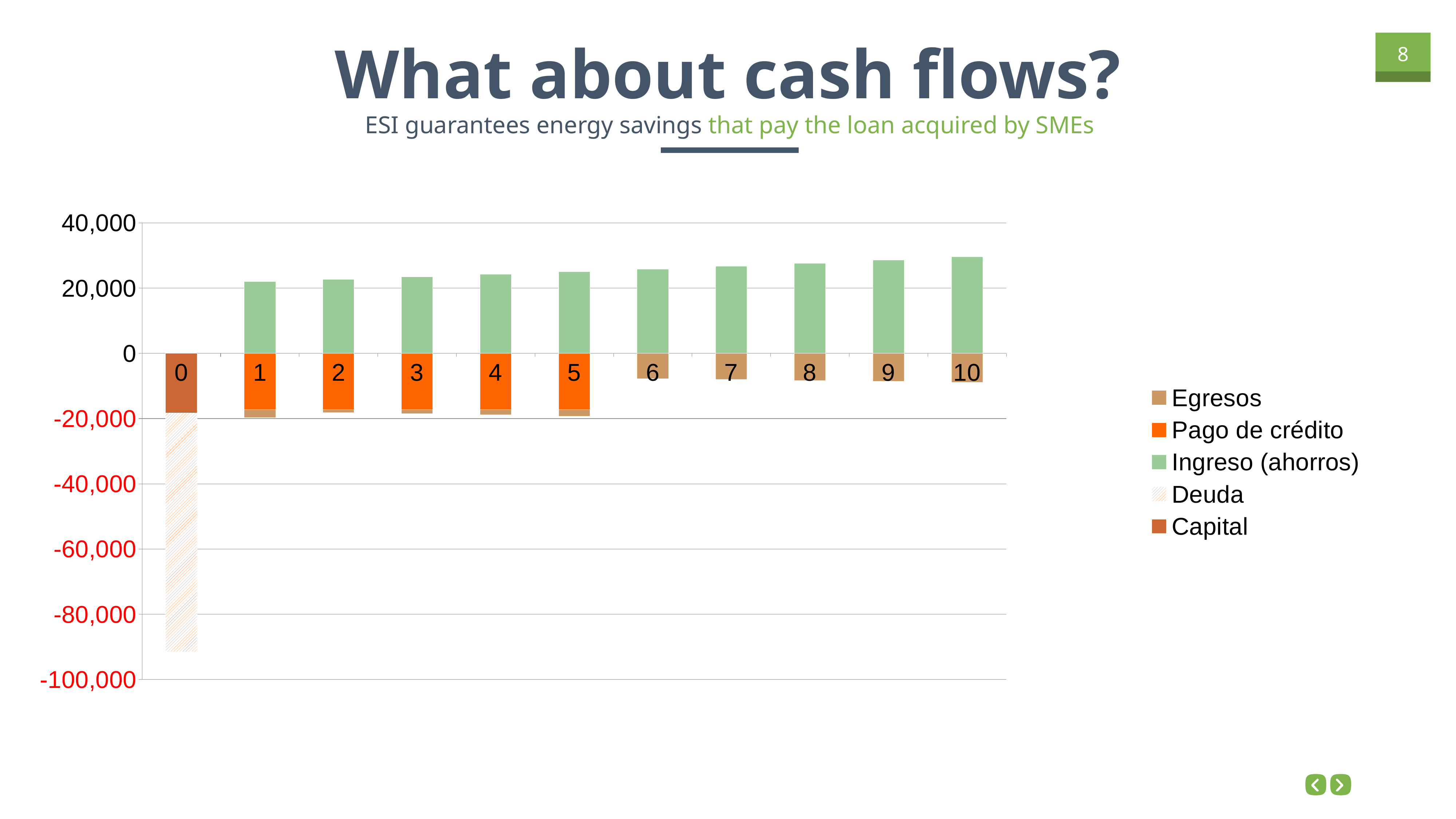
Which is larger, the Ingreso (ahorros) value at year 10 or at year 1? year 10 Is the value for Capital at year 0 greater or less than -20,000? greater In which year is the Ingreso (ahorros) bar the highest? 10 Which series is shown in green in the chart? Ingreso (ahorros) Do the Ingreso (ahorros) values rise or fall from year 1 to year 10? rise Is the value for Deuda at year 0 greater or less than -80,000? greater How many series does the chart legend list? 5 Is the value for Egresos at year 8 greater or less than -20,000? greater What kind of chart is shown on the slide? stacked bar chart How many categories (years) are shown along the x axis of the chart? 11 Which series is shown with a hatched (striped) pattern in the legend? Deuda